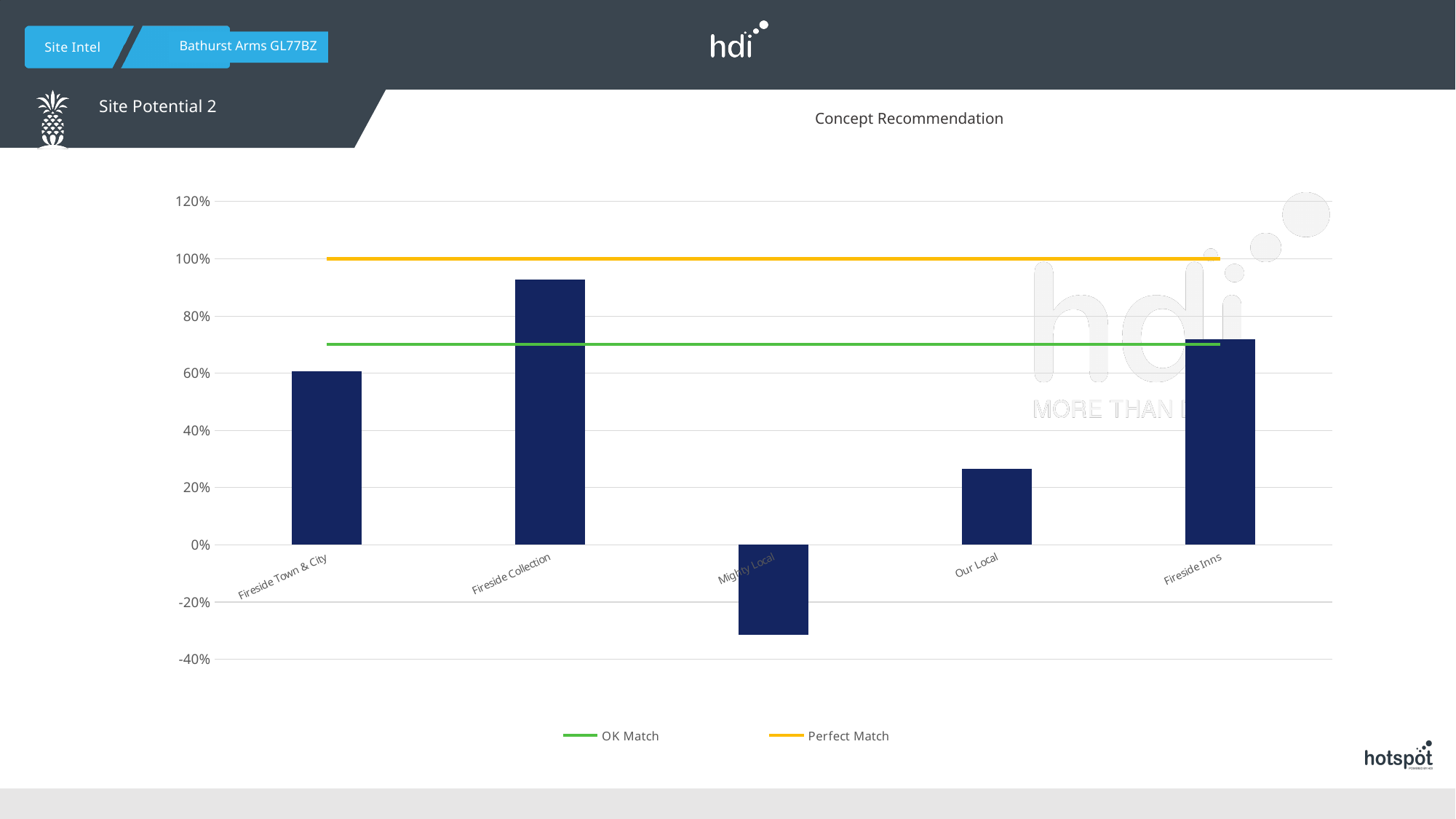
Is the value for Fireside Town & City greater or less than 80%? less Is the value for Our Local greater or less than 40%? less Is the value for Fireside Collection greater or less than 80%? greater At what level on the y axis is the Perfect Match line drawn? 100% Which category has the highest bar in the chart? Fireside Collection Which is larger, the value for Fireside Inns or the value for Fireside Town & City? Fireside Inns How many categories are plotted on the x axis of the chart? 5 What kind of chart is shown on the slide? bar chart How many entries does the chart's legend list? 2 What is the title shown above the chart? Concept Recommendation Which category has the lowest bar in the chart? Mighty Local